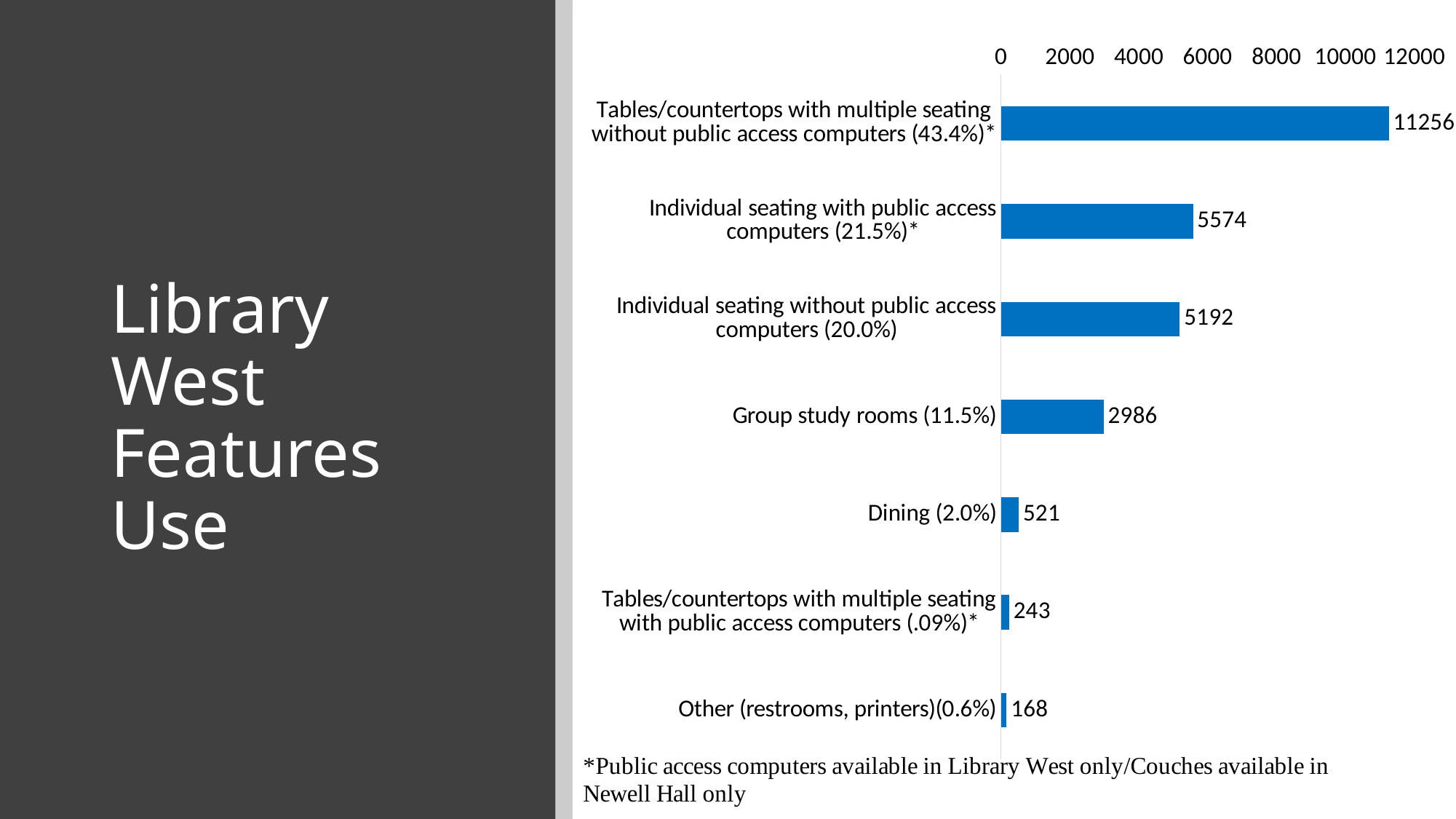
What kind of chart is shown on the slide? bar chart Which is larger: Dining or Tables/countertops with multiple seating with public access computers? Dining Which category has the highest value? Tables/countertops with multiple seating without public access computers What is the title of the slide? Library West Features Use What is the value for Group study rooms? 2986 What is the value for Dining? 521 How many categories are shown in the chart? 7 Which category has the lowest value? Other (restrooms, printers) What is the value for Other (restrooms, printers)? 168 What is the value for Individual seating with public access computers? 5574 What is the difference between Individual seating with public access computers and Individual seating without public access computers? 382 Is the value for Tables/countertops with multiple seating without public access computers greater or less than 10000? greater